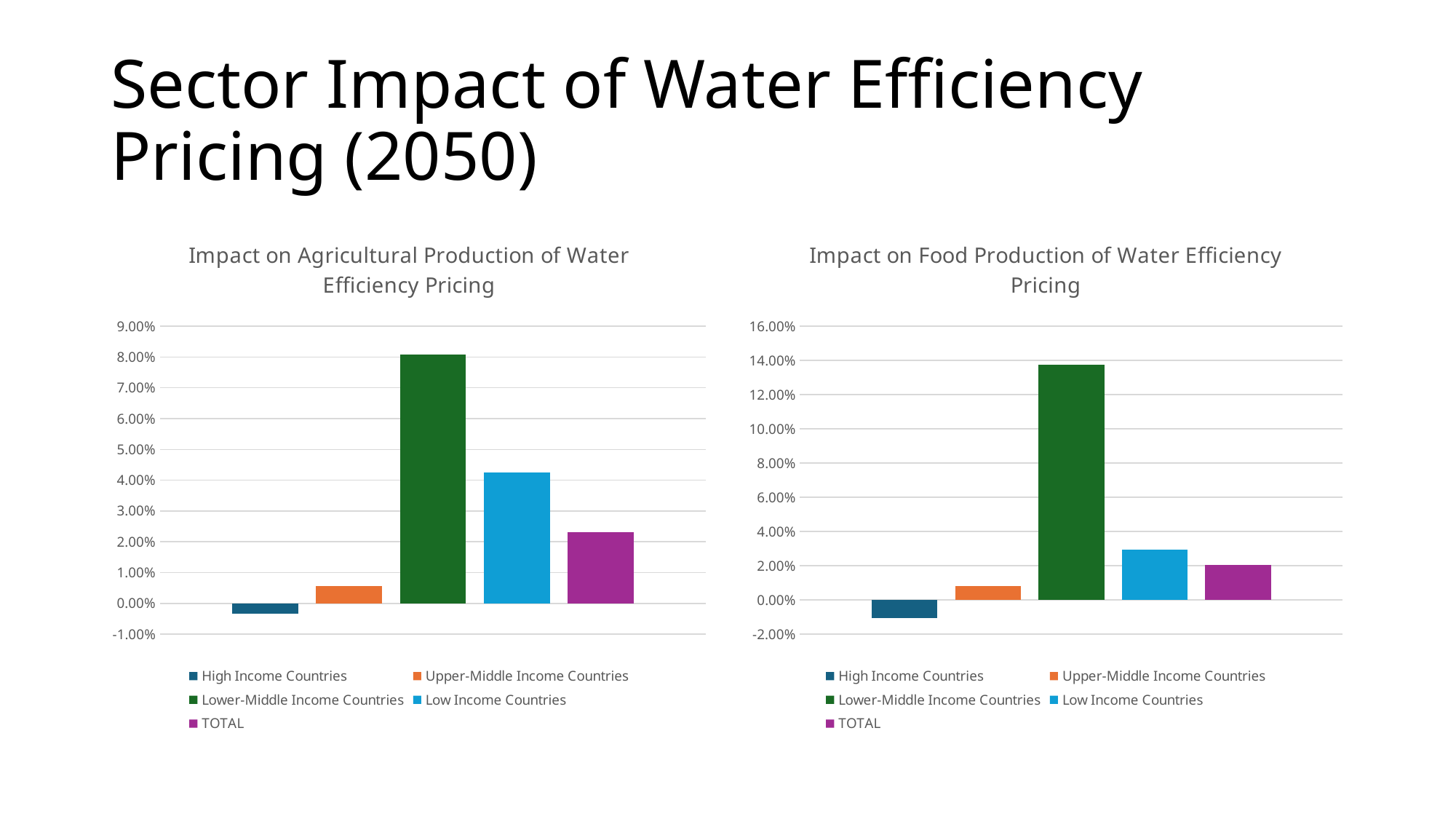
In the right chart, is the value for Lower-Middle Income Countries greater or less than 12.00%? greater In the left chart, is the value for Low Income Countries greater or less than 3.00%? greater In the chart titled 'Impact on Agricultural Production of Water Efficiency Pricing', which series has the highest value? Lower-Middle Income Countries In the left chart, which is larger: the value for Low Income Countries or the value for TOTAL? Low Income Countries How many series does the legend of the right chart list? 5 In the chart titled 'Impact on Food Production of Water Efficiency Pricing', which series has the lowest value? High Income Countries In the right chart, is the value for High Income Countries greater or less than 0.00%? less What kind of chart is the left chart? Bar chart In the chart titled 'Impact on Agricultural Production of Water Efficiency Pricing', which series has the lowest value? High Income Countries In the chart titled 'Impact on Food Production of Water Efficiency Pricing', which series has the highest value? Lower-Middle Income Countries